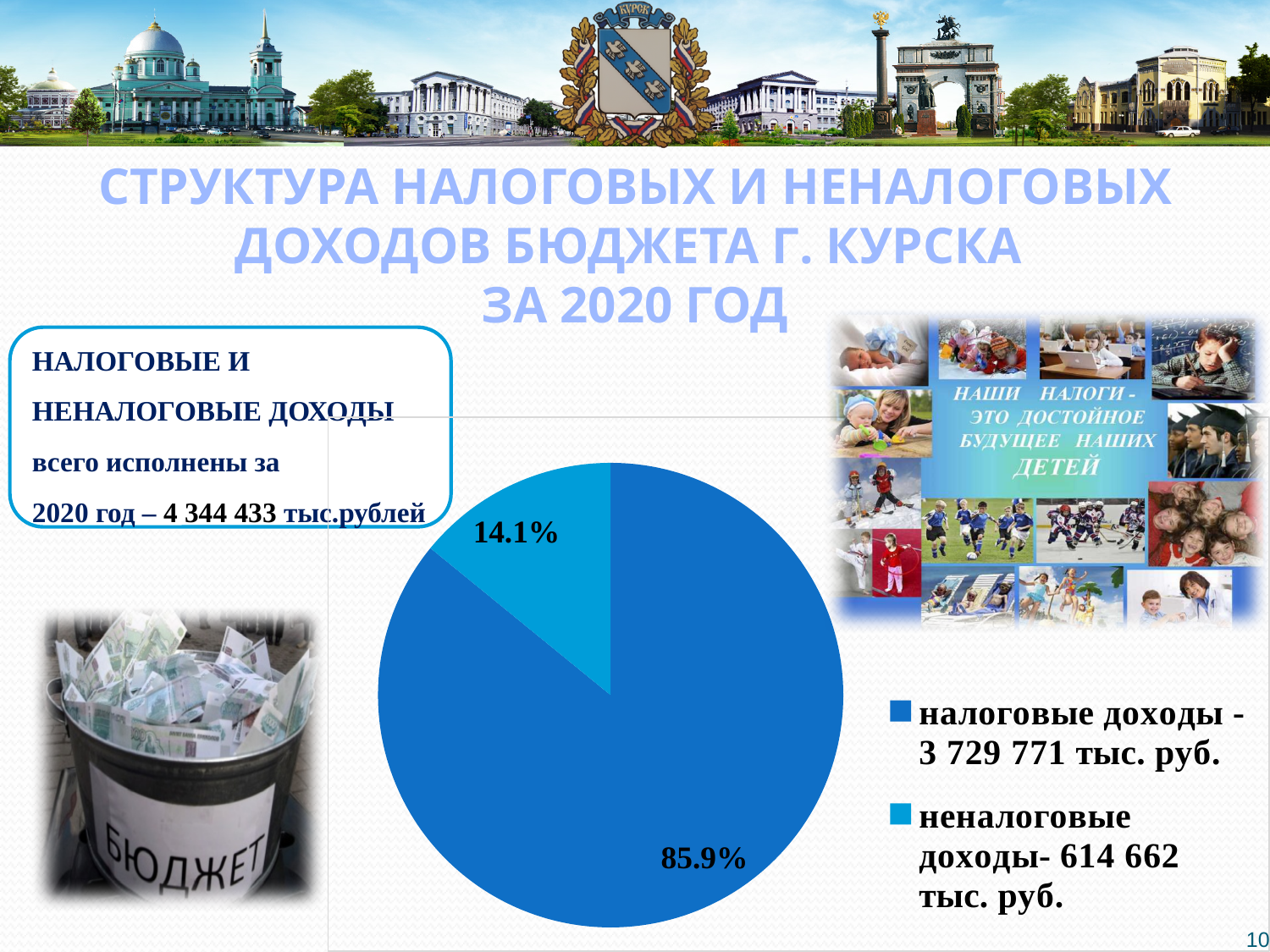
Which slice of the pie is the smallest? неналоговые доходы What colour is the slice for неналоговые доходы? light blue Which is larger, the share of налоговые доходы or the share of неналоговые доходы? налоговые доходы What share of the pie does неналоговые доходы take? 14.1% How many entries does the legend list? 2 What kind of chart is shown on the slide? pie chart What share of the pie does налоговые доходы take? 85.9% How many slices does the pie chart have? 2 What is the difference in percentage points between the налоговые доходы slice and the неналоговые доходы slice? 71.8 Which slice of the pie is the largest? налоговые доходы According to the legend, what is the amount of неналоговые доходы? 614 662 тыс. руб. According to the legend, what is the amount of налоговые доходы? 3 729 771 тыс. руб.